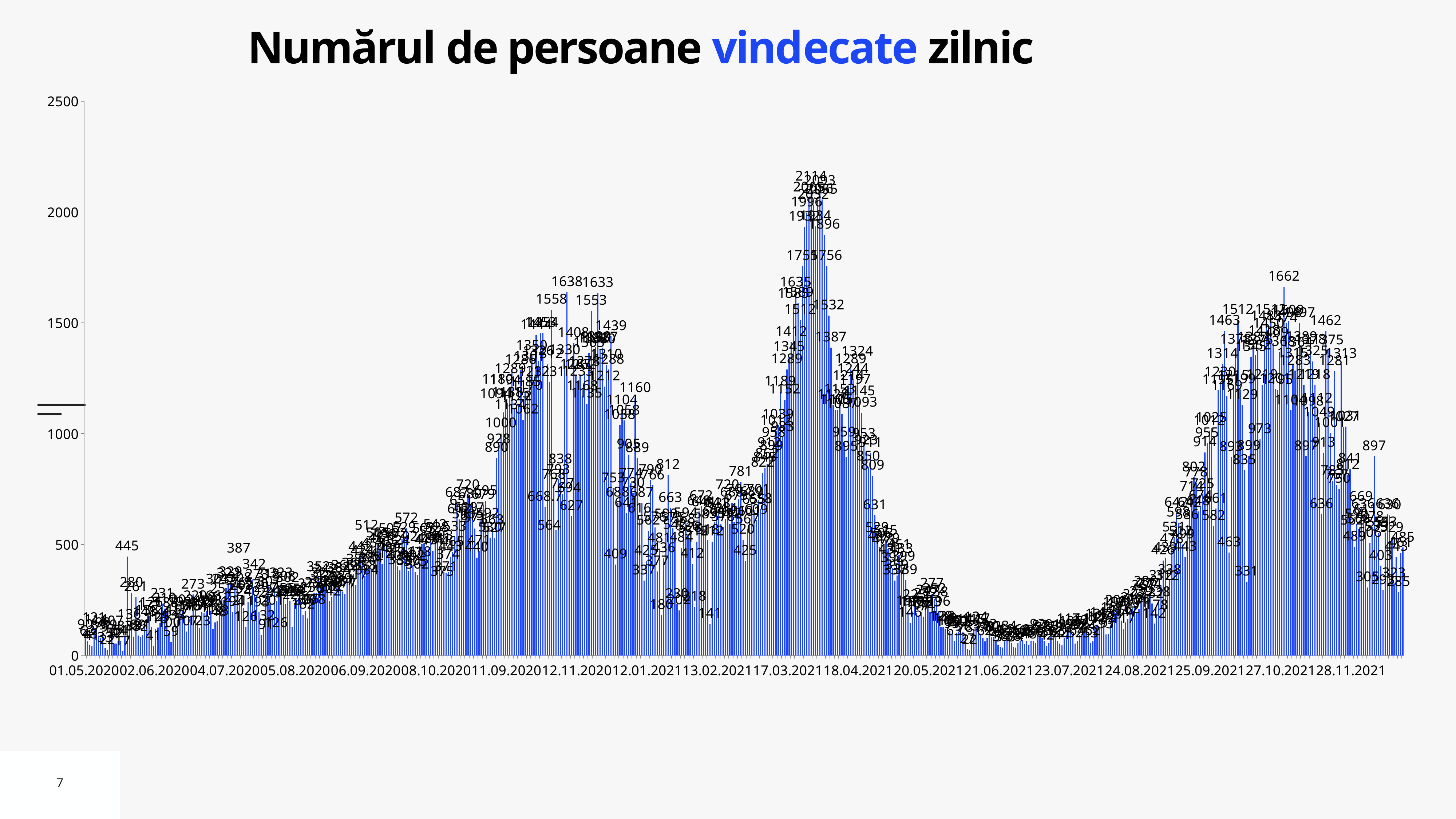
Is the tallest bar around 17.03.2021 greater or less than 2000? greater What is the highest data label shown before 04.07.2020? 445 What is the difference between the peak value 2114 and the peak value 1662? 452 What is the highest data label shown on the chart? 2114 What is the maximum value shown on the vertical axis? 2500 Is the value for 01.05.2020 greater or less than 500? less Do the values rise or fall from 21.06.2021 to 27.10.2021? rise What kind of chart is shown on the slide? bar chart Which is larger: the peak value 2114 (around 17.03.2021) or the peak value 1662 (around 27.10.2021)? 2114 Are the values around 21.06.2021 greater or less than 500? less What is the title of the chart? Numărul de persoane vindecate zilnic What is the highest data label in the wave around 27.10.2021? 1662